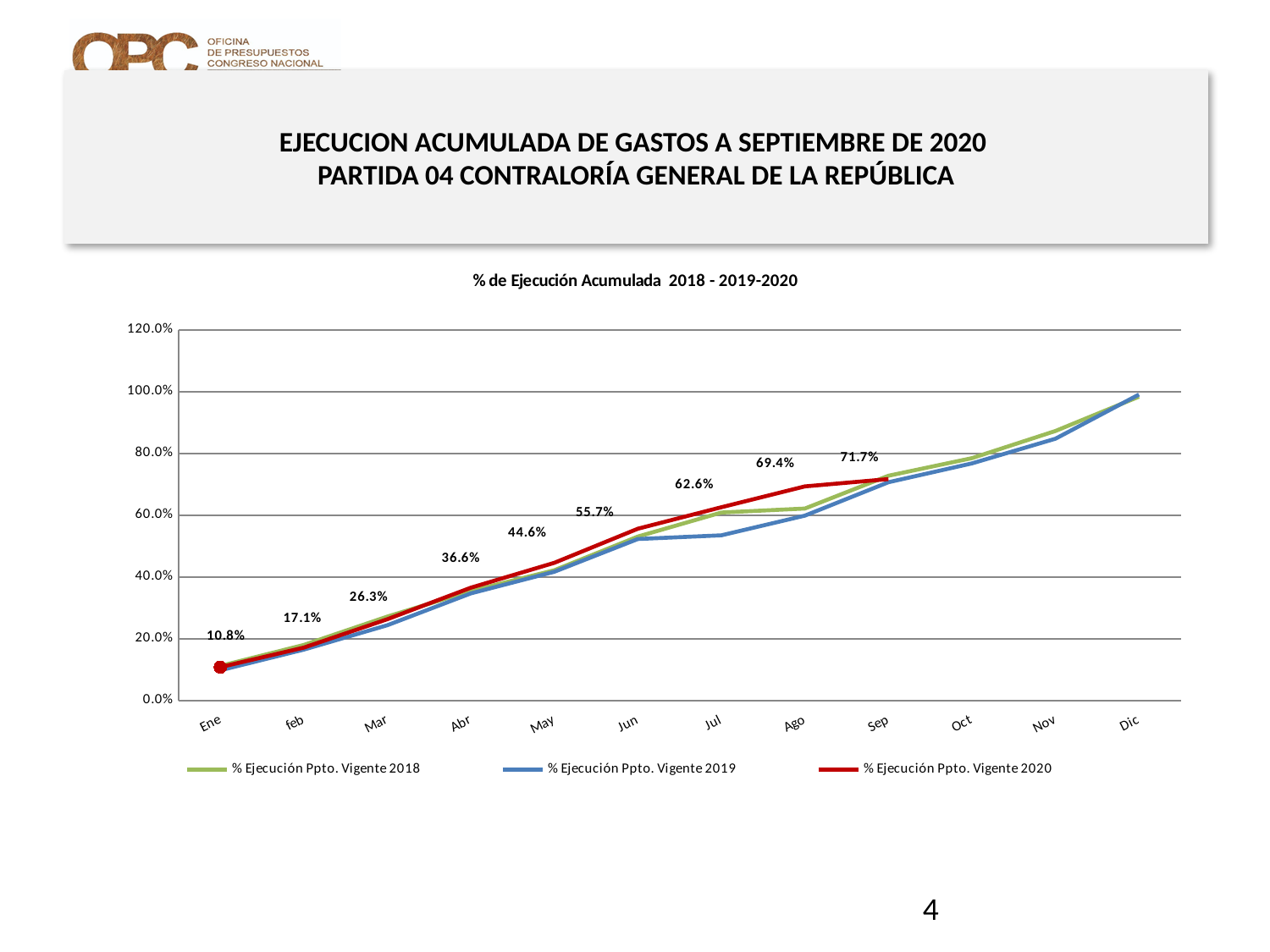
How many series does the legend list? 3 What is the difference between the 2020 values for Jun and May? 11.1% Which colour is used for the % Ejecución Ppto. Vigente 2020 line? red Does the % Ejecución Ppto. Vigente 2020 series rise or fall from Ene to Sep? rise What is the value of % Ejecución Ppto. Vigente 2020 in Ene? 10.8% Is the value for % Ejecución Ppto. Vigente 2019 in Jul greater or less than 60.0%? less What is the value of % Ejecución Ppto. Vigente 2020 in Abr? 36.6% What is the title of the chart? % de Ejecución Acumulada 2018 - 2019-2020 How many months are shown on the x axis? 12 What kind of chart is shown on the slide? line chart What is the value of % Ejecución Ppto. Vigente 2020 in Sep? 71.7% What is the difference between the 2020 values for Sep and Ago? 2.3%